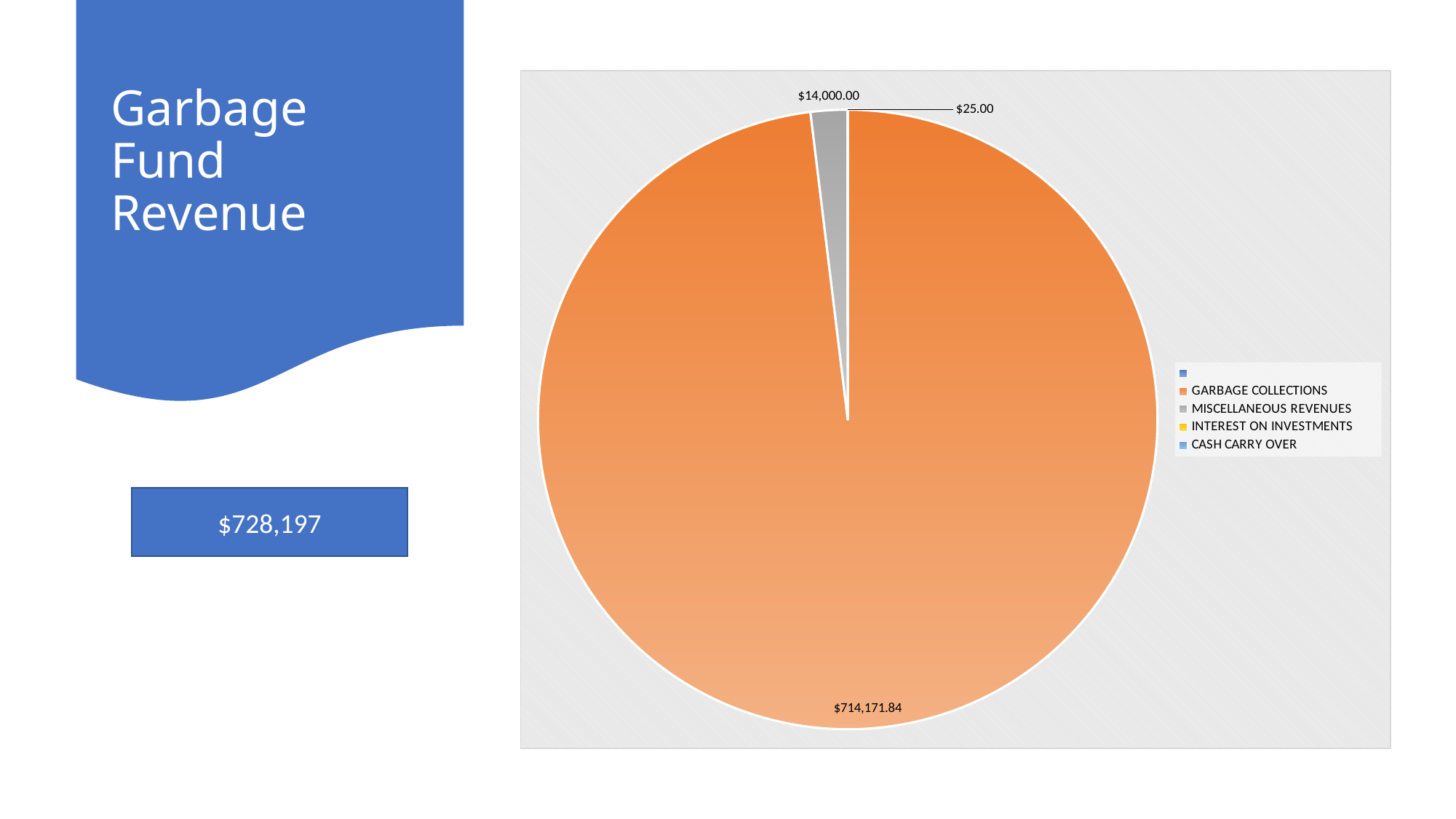
What is the difference between the GARBAGE COLLECTIONS value and the MISCELLANEOUS REVENUES value? $700,171.84 What kind of chart is shown on the slide? Pie chart Which labelled category has the smallest value in the pie chart? INTEREST ON INVESTMENTS Which category has the largest slice of the pie chart? GARBAGE COLLECTIONS How many named categories does the legend list? 4 What value is shown for INTEREST ON INVESTMENTS in the pie chart? $25.00 What value is shown for MISCELLANEOUS REVENUES in the pie chart? $14,000.00 How many data labels are printed on the pie chart? 3 What is the title of the slide containing the pie chart? Garbage Fund Revenue What colour is the GARBAGE COLLECTIONS slice? Orange What value is shown for GARBAGE COLLECTIONS in the pie chart? $714,171.84 Which is larger, MISCELLANEOUS REVENUES or INTEREST ON INVESTMENTS? MISCELLANEOUS REVENUES